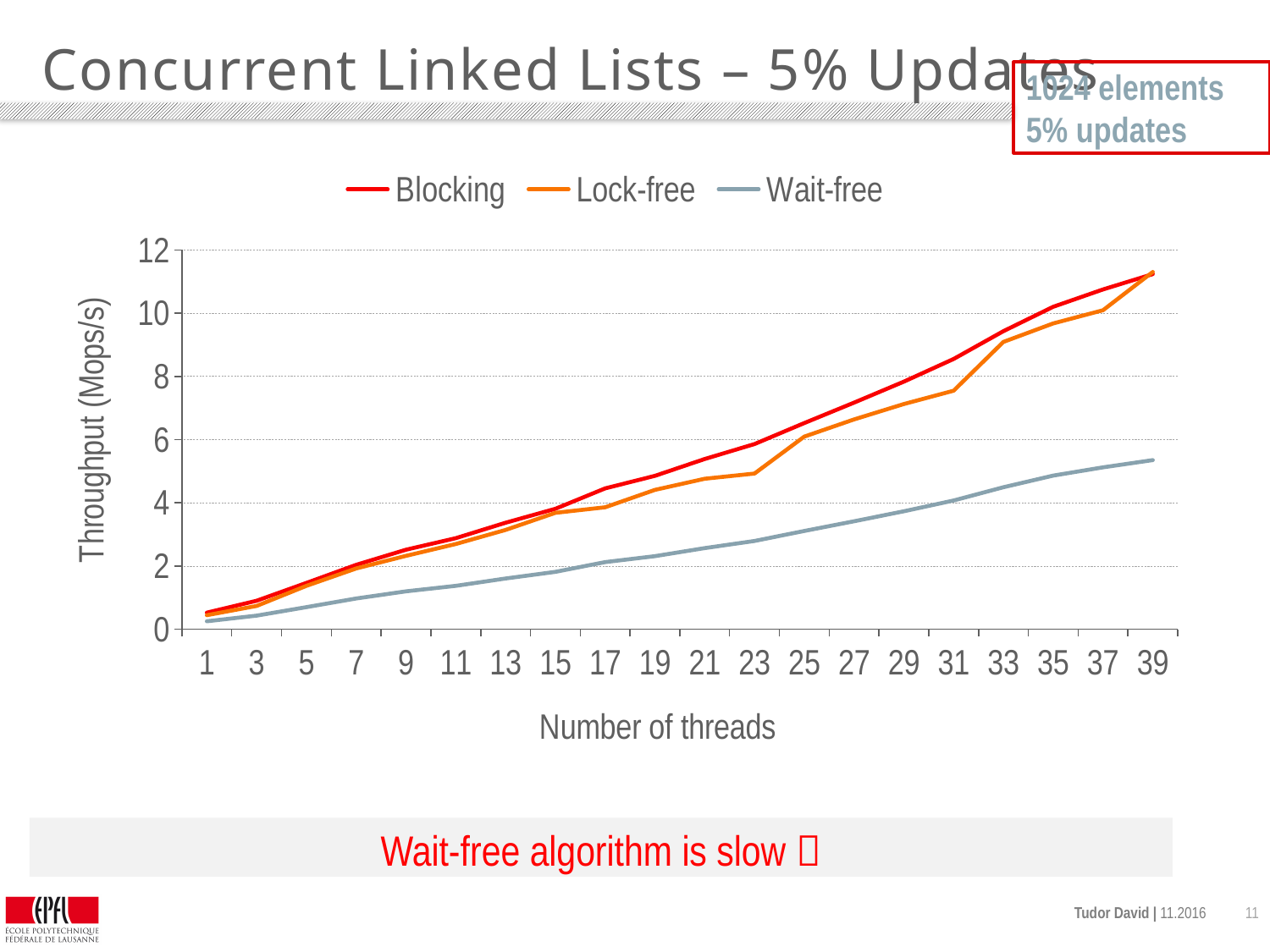
What kind of chart is shown on the slide? Line chart What is the label of the y axis? Throughput (Mops/s) At 31 threads, which has the higher throughput, Blocking or Lock-free? Blocking How many series does the legend list? 3 Is the throughput of the Wait-free series at 39 threads greater or less than 6? less Which series has the lowest throughput at 39 threads? Wait-free At 25 threads, which has the higher throughput, Lock-free or Wait-free? Lock-free Is the throughput of the Blocking series at 39 threads greater or less than 10? greater Does the throughput of the Wait-free series rise or fall as the number of threads increases? Rise Is the throughput of the Wait-free series at 21 threads greater or less than 2? greater Which series are listed in the legend? Blocking, Lock-free, Wait-free